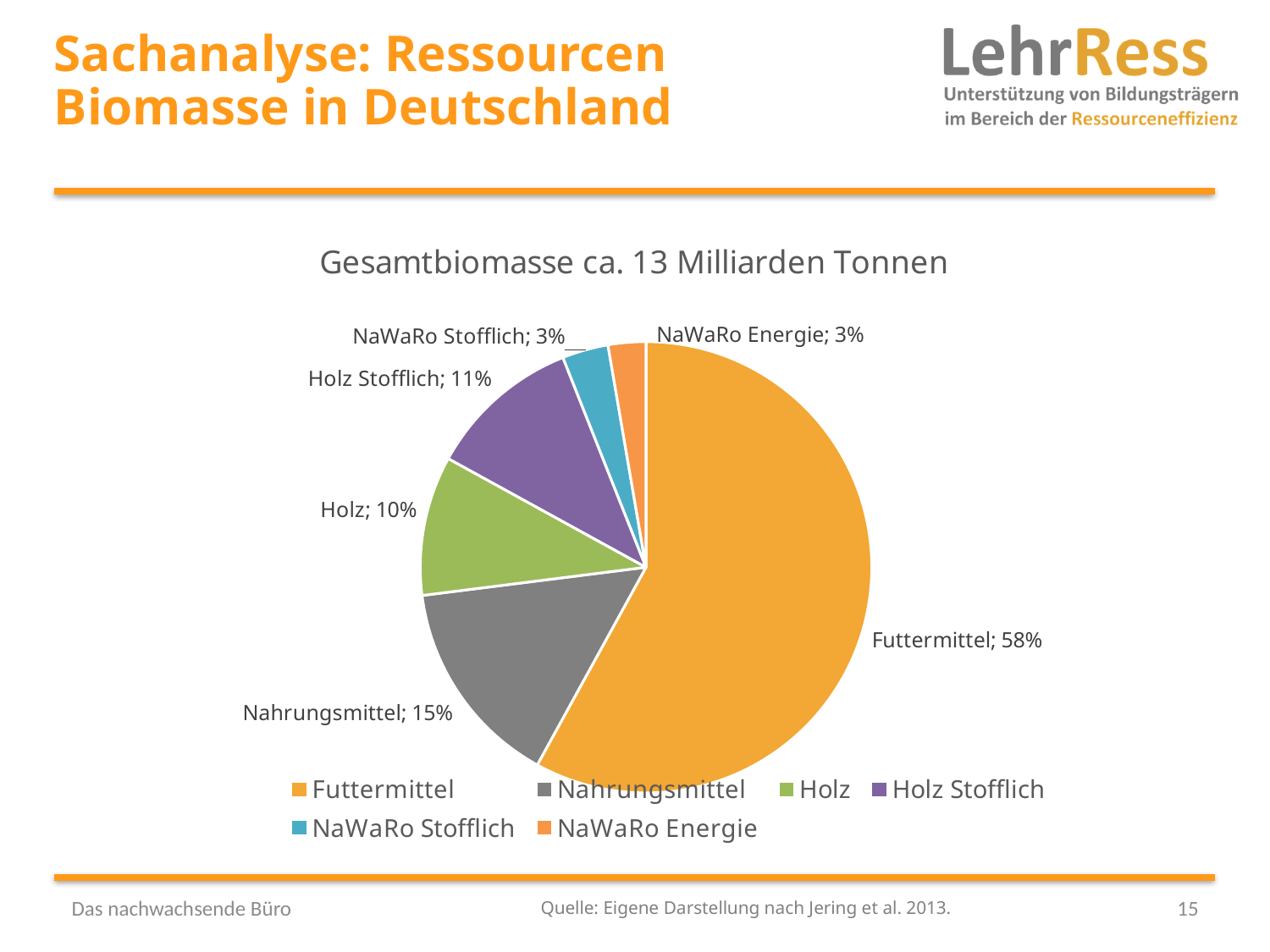
What is the value shown for Nahrungsmittel? 15% Which is larger, Holz Stofflich or Holz? Holz Stofflich What is the value shown for Holz? 10% Which category has the largest slice of the pie? Futtermittel What is the value shown for Holz Stofflich? 11% What kind of chart is shown on the slide? Pie chart Which colour represents Nahrungsmittel in the legend? Grey How many slices does the pie chart have? 6 What is the combined share of NaWaRo Stofflich and NaWaRo Energie? 6% What is the title of the chart? Gesamtbiomasse ca. 13 Milliarden Tonnen What share of the pie does Futtermittel have? 58% What is the difference in percentage points between Futtermittel and Nahrungsmittel? 43